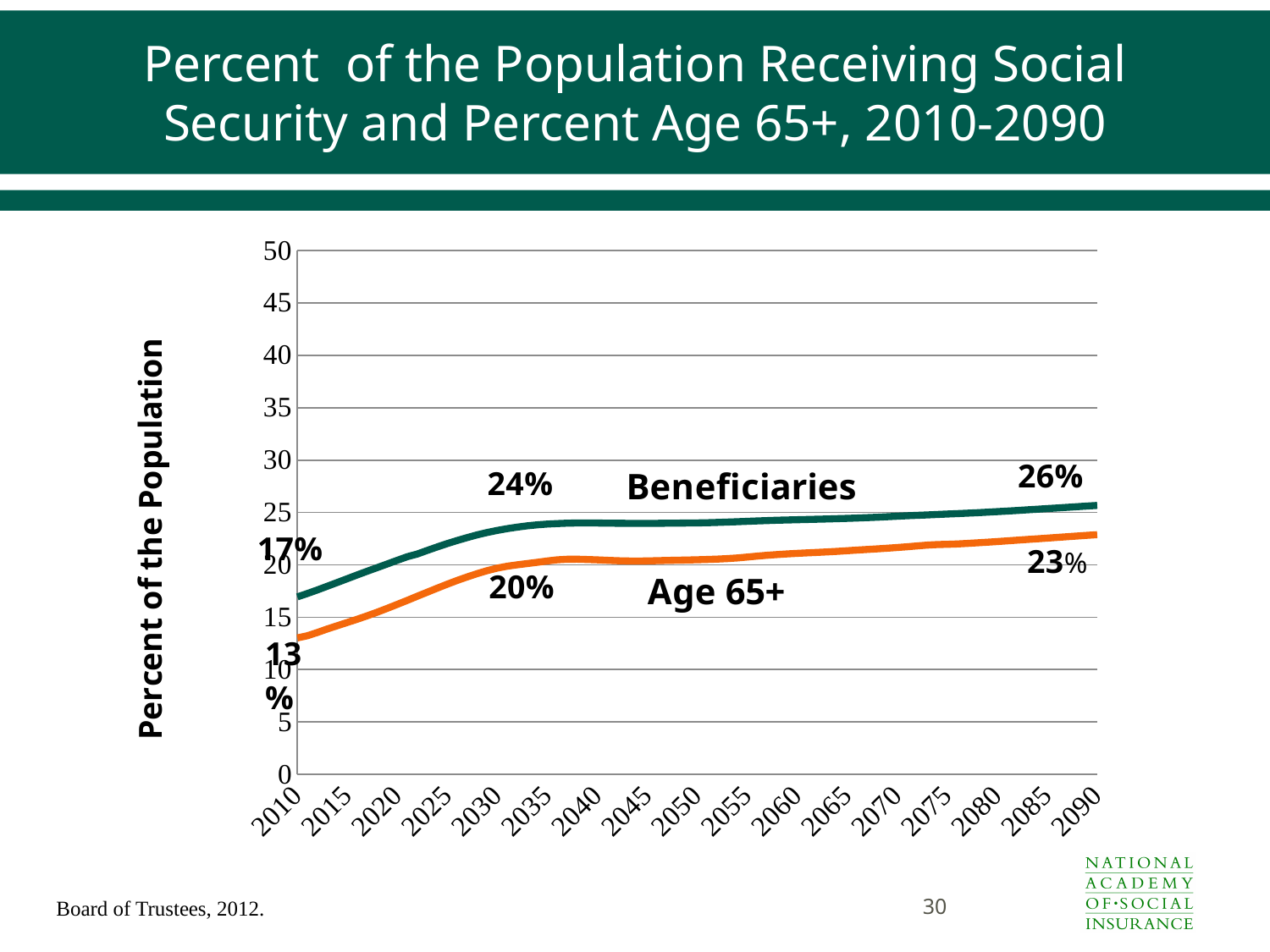
What is the difference between the Beneficiaries and Age 65+ values in 2010? 4% Is the value for Beneficiaries in 2050 greater or less than 20? greater What is the title of the y axis? Percent of the Population Do the Beneficiaries values rise or fall from 2010 to 2090? rise What is the value for Age 65+ in 2010? 13% What is the difference between the Beneficiaries and Age 65+ values in 2090? 3% What is the value for Age 65+ in 2090? 23% How many years are labelled on the x axis? 17 Which series has the higher value in 2090, Beneficiaries or Age 65+? Beneficiaries What is the value for Beneficiaries in 2090? 26% What is the value for Beneficiaries in 2010? 17% What kind of chart is shown on the slide? line chart